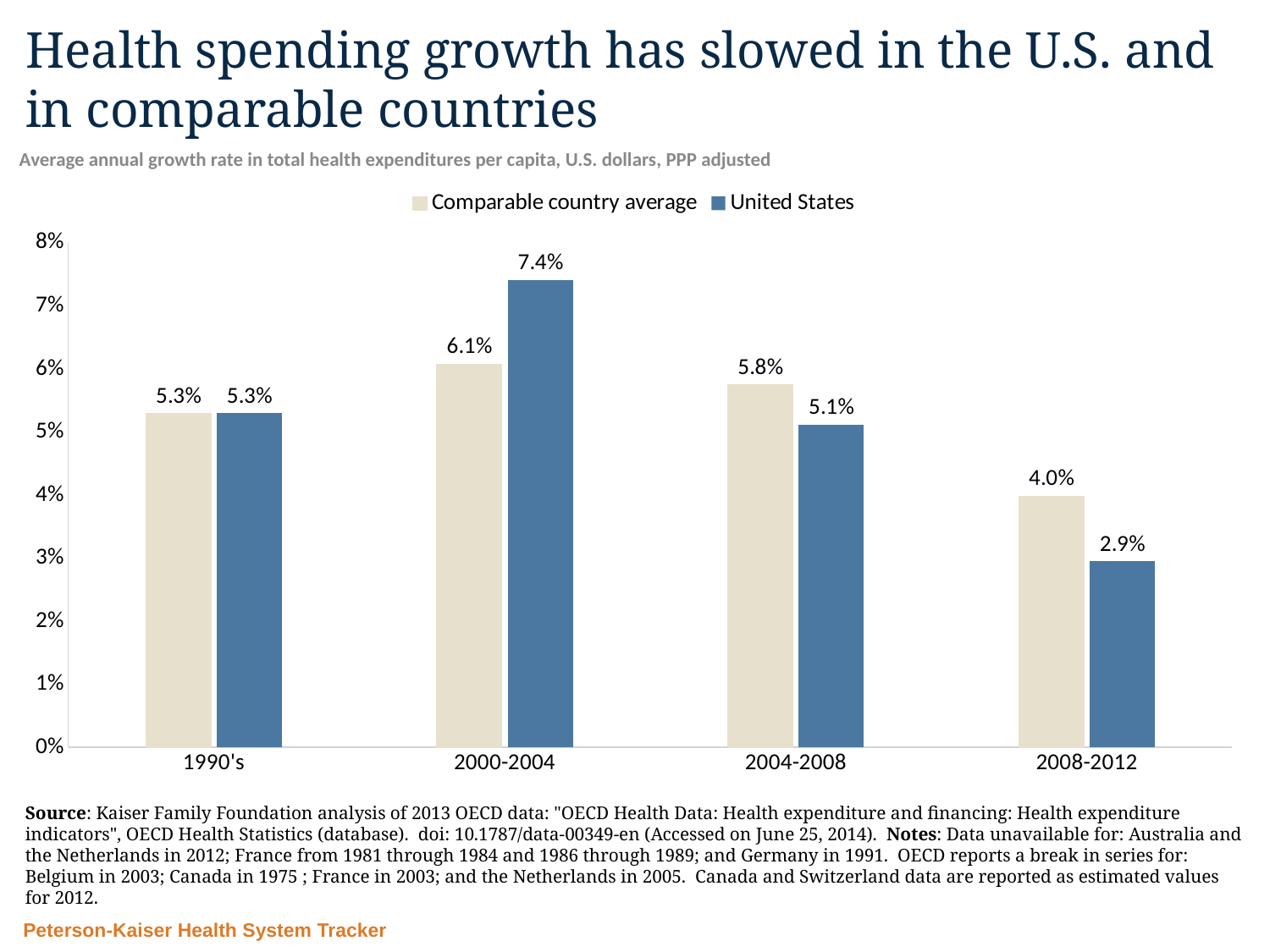
From 2000-2004 to 2008-2012, does the United States growth rate rise or fall? Fall What was the comparable country average growth rate in the 1990's? 5.3% In which period was the United States growth rate highest? 2000-2004 In 2004-2008, which was higher: the United States growth rate or the comparable country average? Comparable country average In which period was the comparable country average growth rate lowest? 2008-2012 What is the difference between the United States and comparable country average growth rates in 2000-2004? 1.3 percentage points What was the United States average annual growth rate in health expenditures per capita in 2000-2004? 7.4% What type of chart is shown on the slide? Bar chart What was the comparable country average growth rate in 2008-2012? 4.0% How many time periods are shown on the x axis? 4 How many series does the legend list? 2 Which colour represents the United States in the chart? Blue